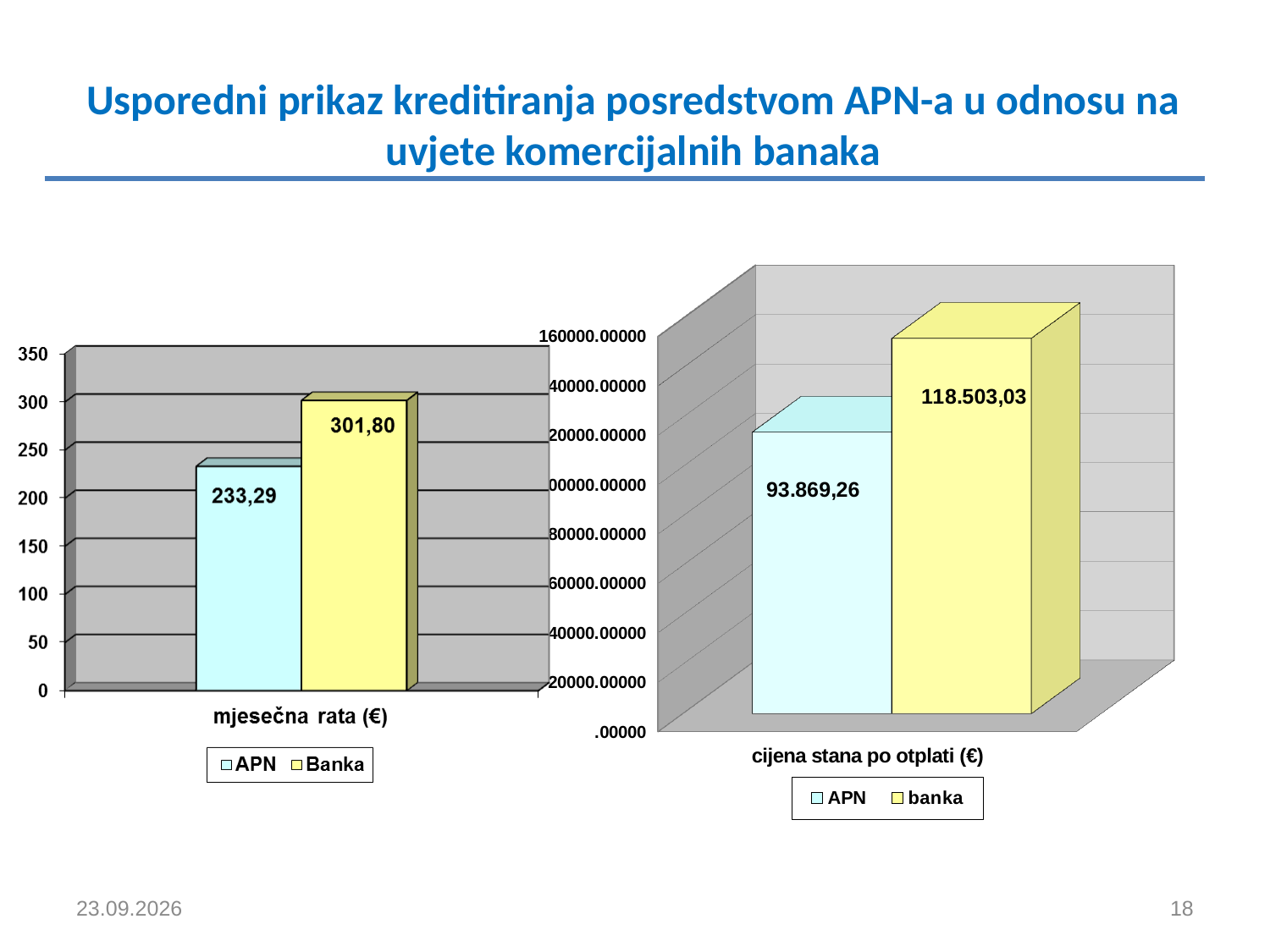
What is the category label shown under the bars of the right chart? cijena stana po otplati (€) In the left chart (mjesečna rata (€)), what is the value for Banka? 301,80 In the right chart (cijena stana po otplati (€)), what is the value for banka? 118.503,03 In the left chart (mjesečna rata (€)), which series has the higher value? Banka How many series does the legend of the right chart (cijena stana po otplati (€)) list? 2 In the right chart (cijena stana po otplati (€)), which series has the lower value? APN In the right chart (cijena stana po otplati (€)), what is the value for APN? 93.869,26 In the right chart (cijena stana po otplati (€)), what is the difference between the banka value and the APN value? 24.633,77 In the left chart (mjesečna rata (€)), is the value for APN greater or less than 250? less In the left chart (mjesečna rata (€)), what is the difference between the Banka value and the APN value? 68,51 What kind of chart is the left chart (mjesečna rata (€))? bar chart In the left chart (mjesečna rata (€)), what is the value for APN? 233,29